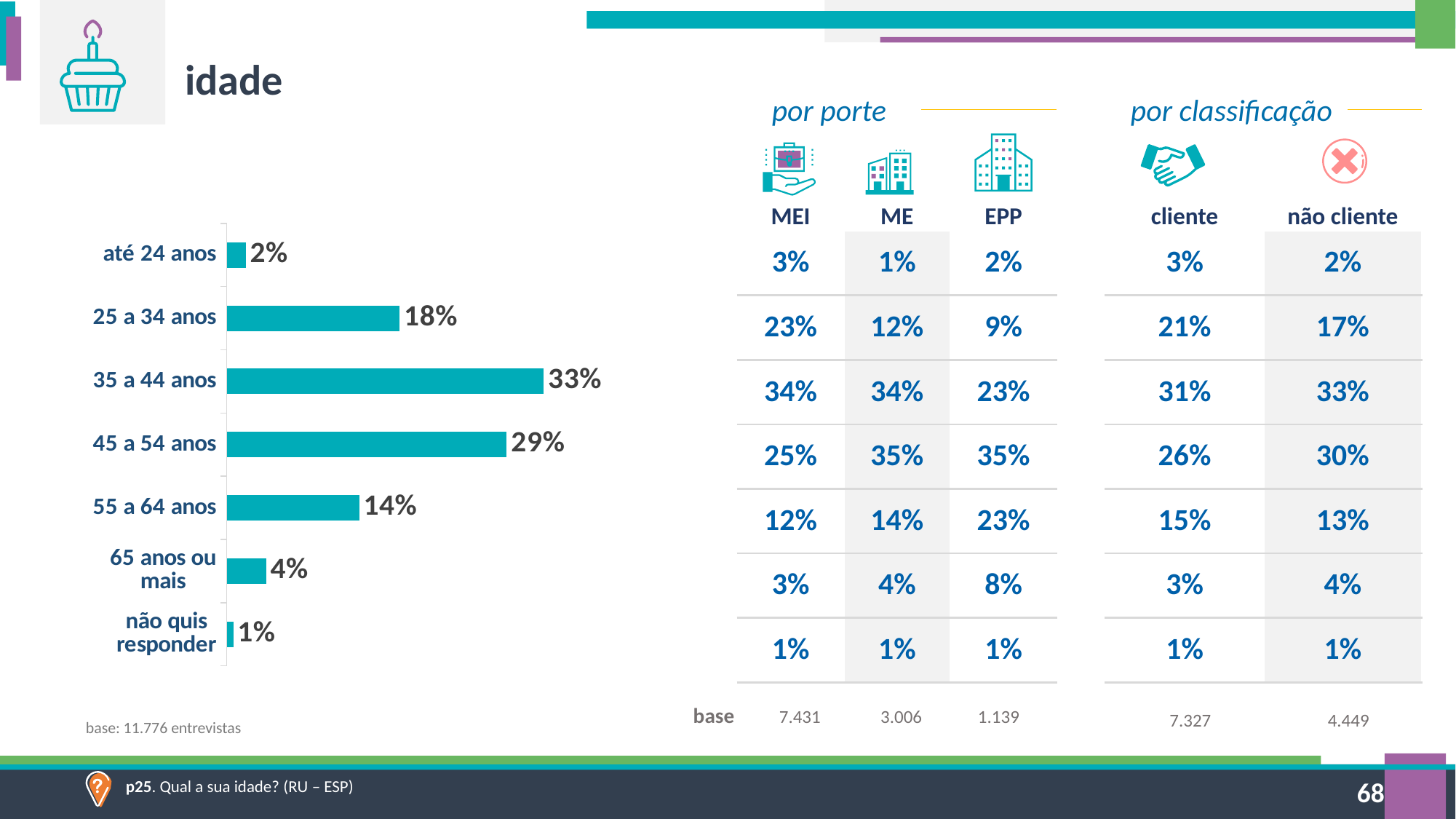
What kind of chart is shown on the slide? bar chart What is the value for the '25 a 34 anos' category in the bar chart? 18% What is the value for '65 anos ou mais' in the bar chart? 4% What is the difference between the values for '35 a 44 anos' and '45 a 54 anos' in the bar chart? 4% Which category has the highest value in the bar chart? 35 a 44 anos Which is larger in the bar chart: the value for '45 a 54 anos' or '55 a 64 anos'? 45 a 54 anos What is the difference between the values for '25 a 34 anos' and '55 a 64 anos' in the bar chart? 4% What is the base (number of interviews) stated below the bar chart? 11.776 entrevistas How many categories are shown in the bar chart? 7 What is the value for the '35 a 44 anos' category in the bar chart? 33% Which category has the lowest value in the bar chart? não quis responder What is the title of the slide containing the bar chart? idade